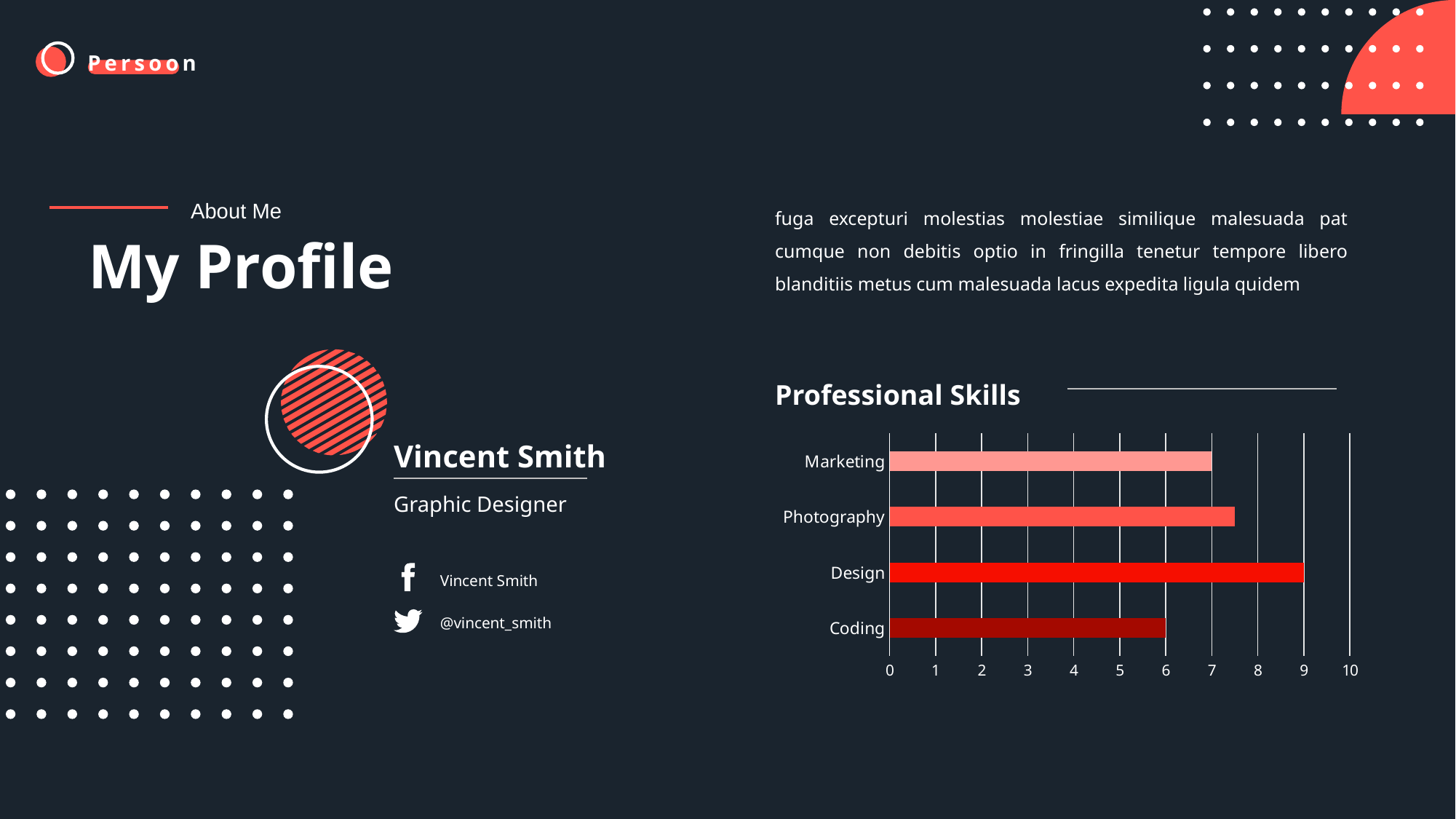
What is the value for Coding in the Professional Skills chart? 6 What is the value for Marketing in the Professional Skills chart? 7 What is the value for Design in the Professional Skills chart? 9 Is the value for Photography greater or less than 8 in the Professional Skills chart? less Is the value for Photography greater or less than 7 in the Professional Skills chart? greater Which skill has the lowest value in the Professional Skills chart? Coding Which is larger in the Professional Skills chart, Design or Photography? Design What kind of chart is shown under "Professional Skills"? bar chart Which skill has the highest value in the Professional Skills chart? Design How many skill categories are plotted in the Professional Skills chart? 4 What is the difference between the Design and Coding values in the Professional Skills chart? 3 What is the title of the chart on the slide? Professional Skills